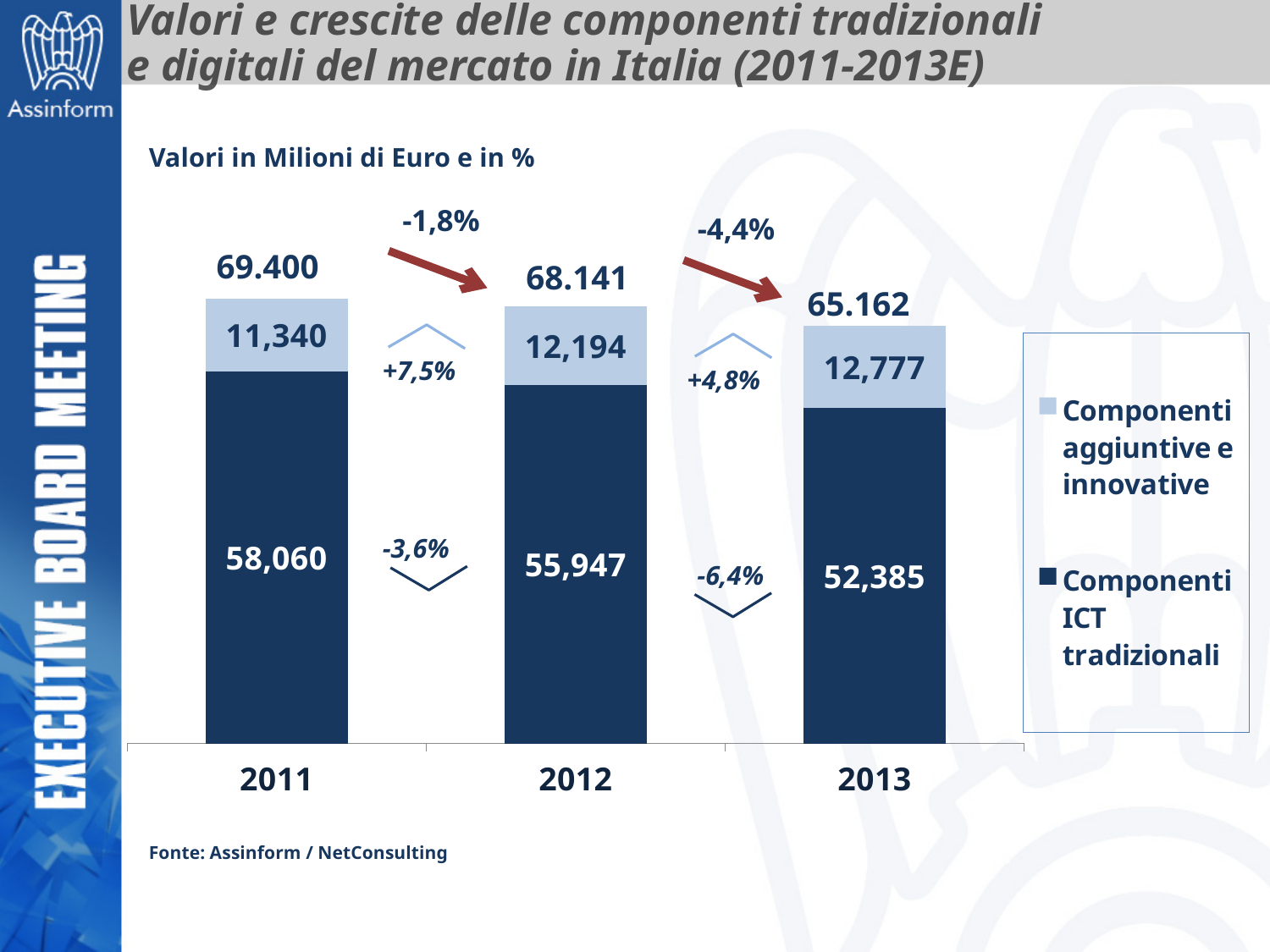
What is the difference between Componenti ICT tradizionali in 2011 and in 2012? 2,113 What is the total value shown above the 2011 bar? 69.400 In which year is Componenti ICT tradizionali lowest? 2013 How does Componenti ICT tradizionali change from 2011 to 2013? It falls Which is larger: Componenti ICT tradizionali in 2012 or in 2013? 2012 What is the total value shown above the 2013 bar? 65.162 What is the value of Componenti aggiuntive e innovative in 2012? 12,194 What is the value of Componenti aggiuntive e innovative in 2013? 12,777 What is the value of Componenti ICT tradizionali in 2011? 58,060 How many series does the legend list? 2 What percentage change is shown for the total market between 2012 and 2013? -4,4% In which year is Componenti aggiuntive e innovative highest? 2013